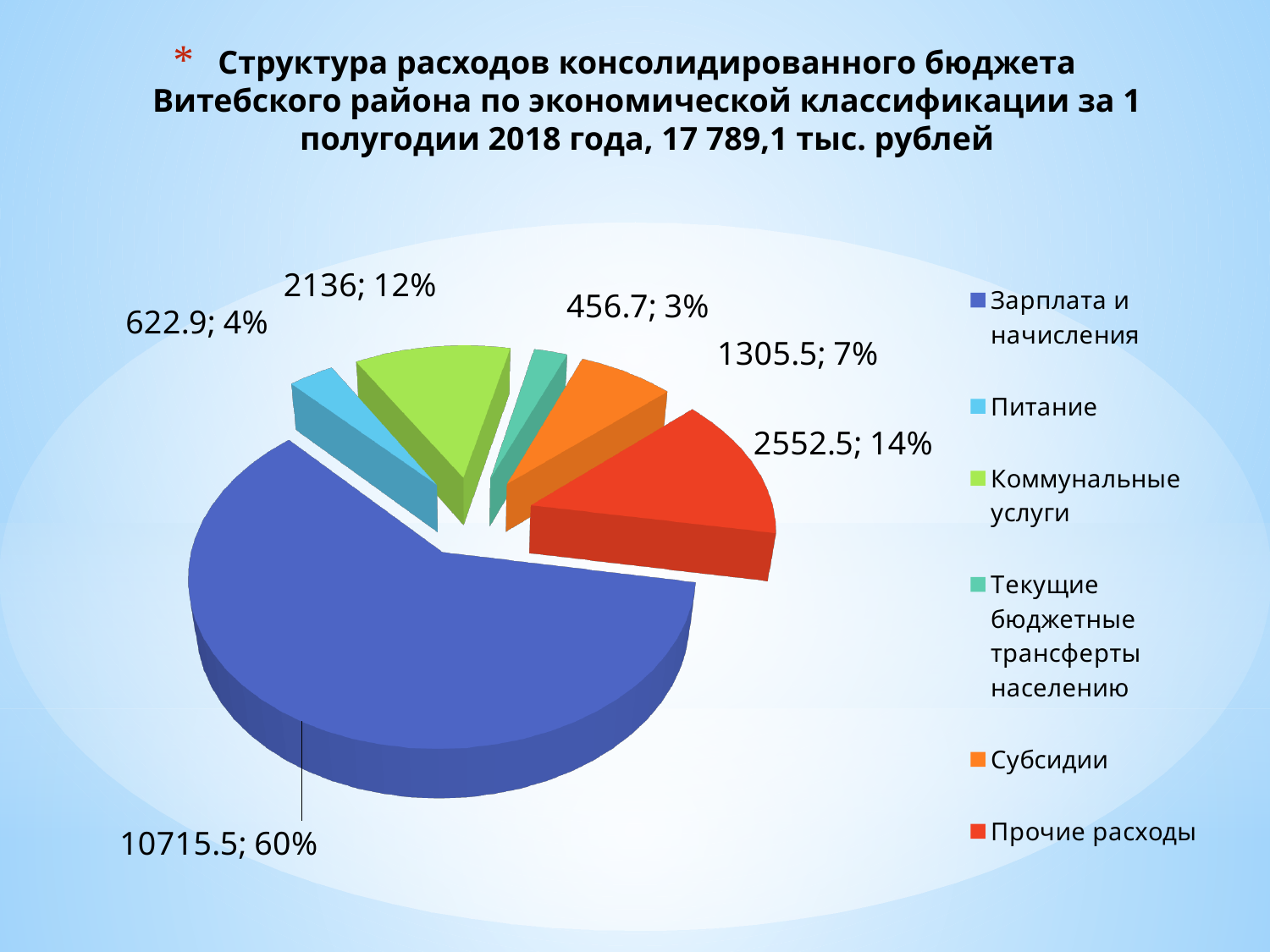
Which category has the largest slice? Зарплата и начисления What value is shown for Прочие расходы? 2552.5 Which is larger, the value for Питание or the value for Субсидии? Субсидии Which category has the smallest slice? Текущие бюджетные трансферты населению How many categories does the pie chart show? 6 What is the difference between the values for Прочие расходы and Субсидии? 1247 What share of the pie does Коммунальные услуги take? 12% What value is shown for Зарплата и начисления? 10715.5 What kind of chart is shown on the slide? Pie chart What share of the pie does Зарплата и начисления take? 60% What colour is the slice for Коммунальные услуги? Green What value is shown for Текущие бюджетные трансферты населению? 456.7